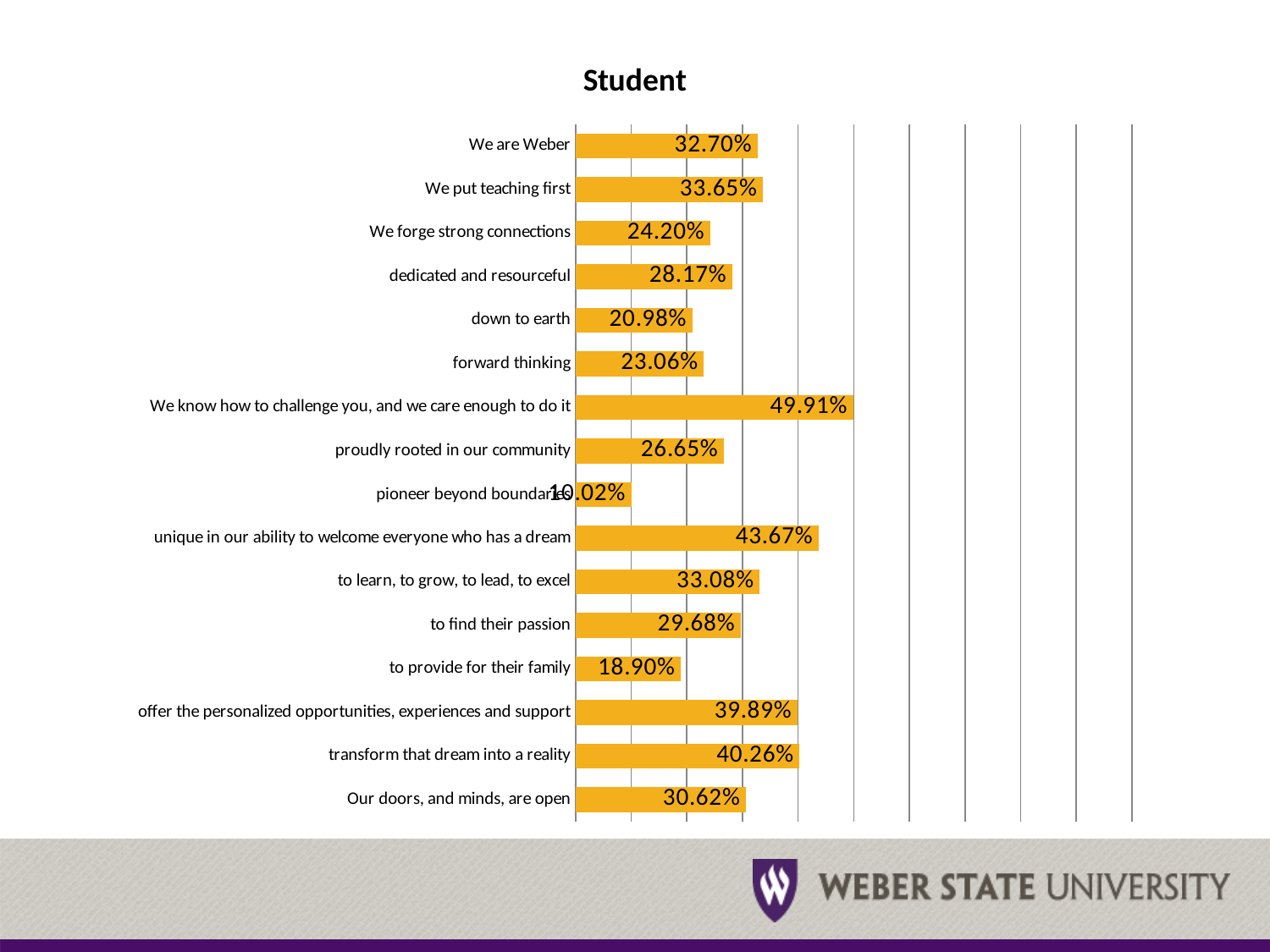
Which category has the highest value? We know how to challenge you, and we care enough to do it What kind of chart is shown on the slide? Bar chart What is the value for "Our doors, and minds, are open"? 30.62% What is the value for "We know how to challenge you, and we care enough to do it"? 49.91% What is the difference between the values for "We put teaching first" and "We are Weber"? 0.95% What is the title of the chart? Student What is the value for "to provide for their family"? 18.90% What is the value for "transform that dream into a reality"? 40.26% What is the difference between the values for "unique in our ability to welcome everyone who has a dream" and "to find their passion"? 13.99% How many categories are shown in the chart? 16 Which category has the lowest value? pioneer beyond boundaries Which is larger, the value for "dedicated and resourceful" or the value for "forward thinking"? dedicated and resourceful